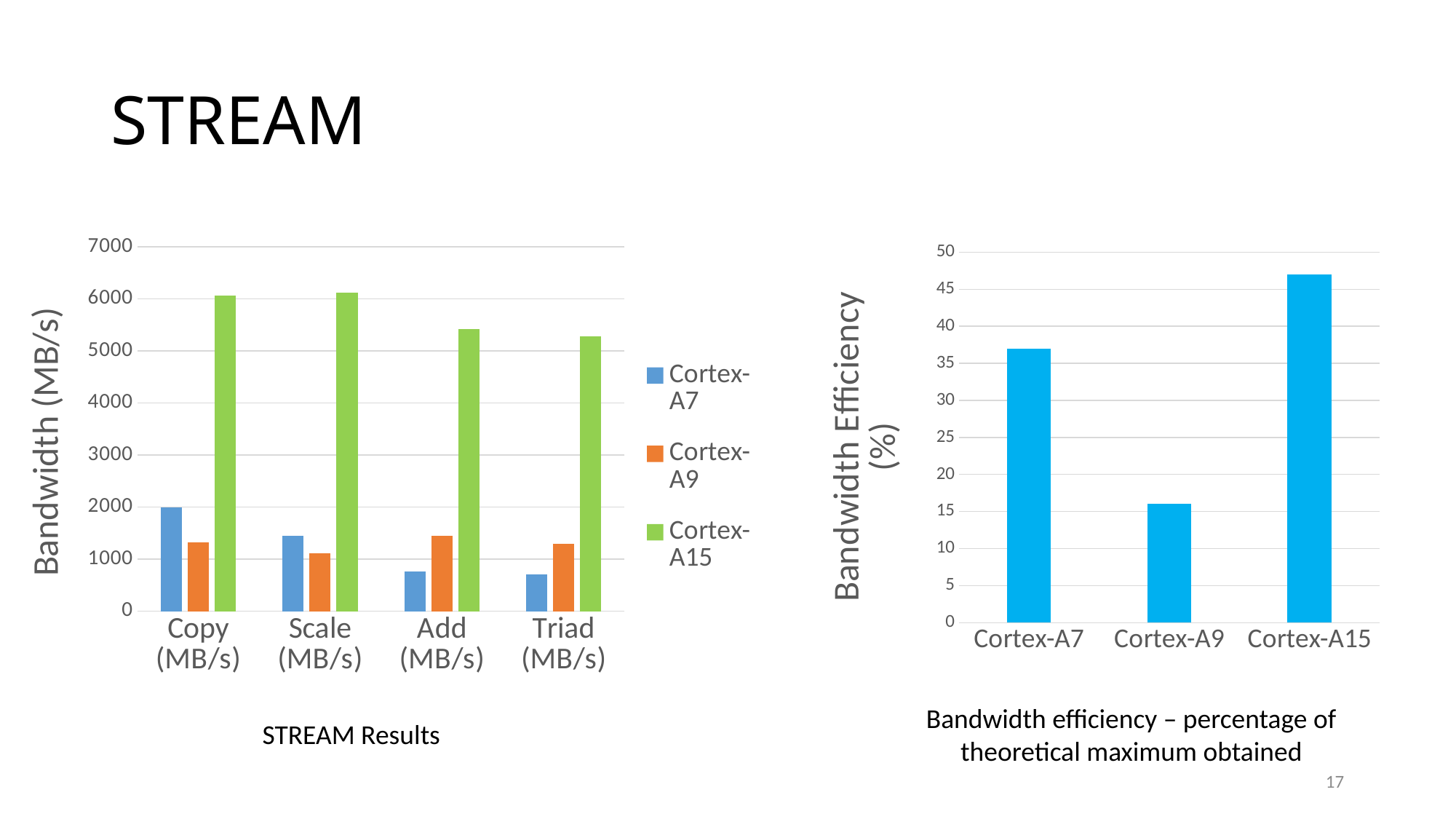
In the Bandwidth efficiency chart, which processor has the lowest bandwidth efficiency? Cortex-A9 In the STREAM Results chart, which series has the highest bandwidth for Copy (MB/s)? Cortex-A15 In the STREAM Results chart, is the Cortex-A7 value for Add (MB/s) greater or less than 1000? less In the STREAM Results chart, which is larger for Add (MB/s): Cortex-A7 or Cortex-A9? Cortex-A9 In the Bandwidth efficiency chart, which processor has the highest bandwidth efficiency? Cortex-A15 In the STREAM Results chart, how many categories are shown on the x axis? 4 In the STREAM Results chart, is the Cortex-A15 value for Triad (MB/s) greater or less than 5000? greater In the STREAM Results chart, what colour represents Cortex-A15? green In the Bandwidth efficiency chart, is the value for Cortex-A15 greater or less than 40? greater In the STREAM Results chart, what kind of chart is shown? bar chart In the STREAM Results chart, how many series does the legend list? 3